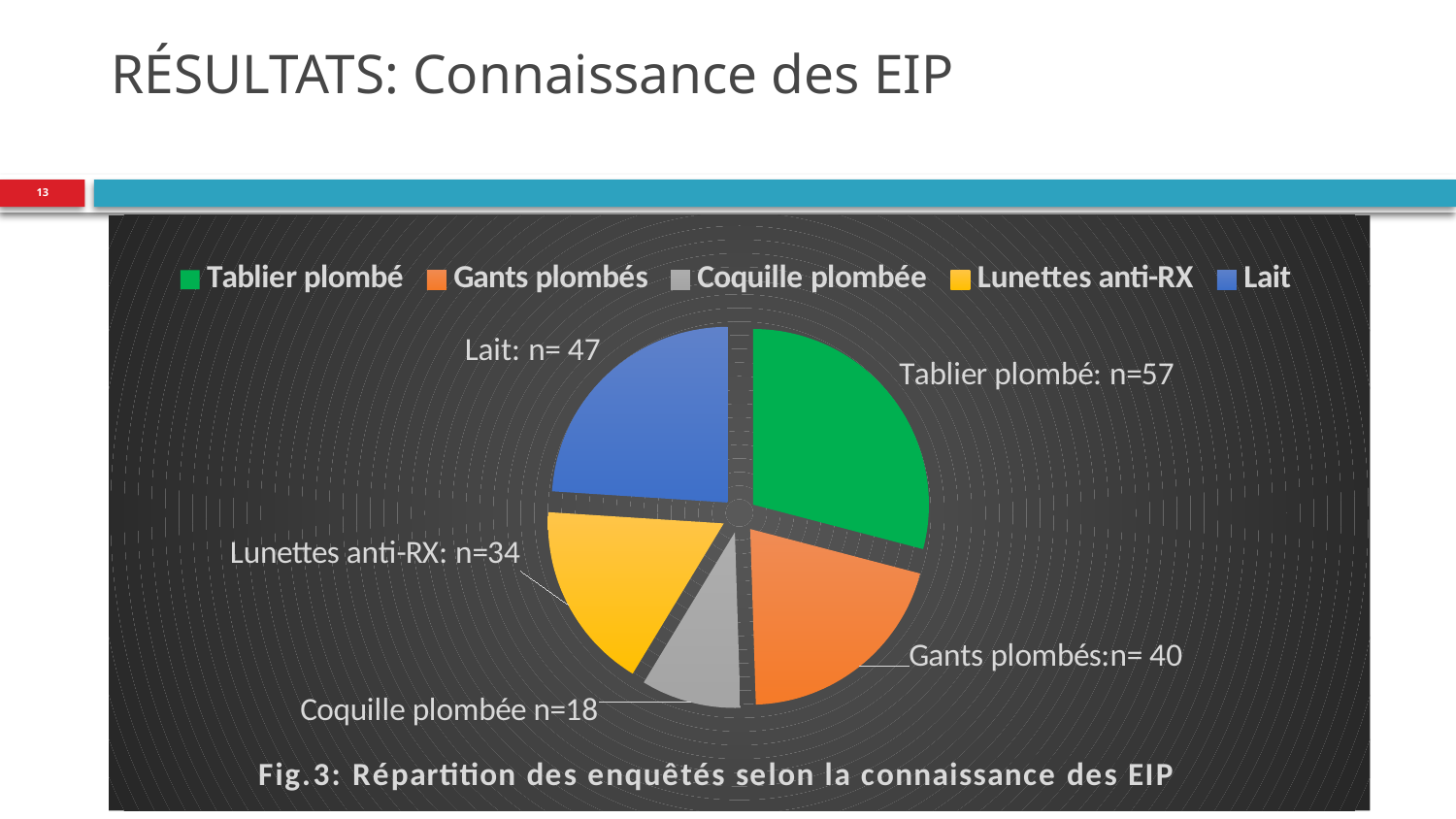
How many slices does the pie chart have? 5 What is the difference between the values for Tablier plombé and Lunettes anti-RX? 23 Which is larger, the value for Lait or the value for Gants plombés? Lait Which category has the largest slice? Tablier plombé How many entries does the legend list? 5 Which category has the smallest slice? Coquille plombée What is the value for Gants plombés? n= 40 What is the value for Tablier plombé? n=57 What type of chart is shown on the slide? pie chart What is the caption of the figure shown below the pie chart? Fig.3: Répartition des enquêtés selon la connaissance des EIP What is the value for Lait? n= 47 What is the value for Coquille plombée? n=18